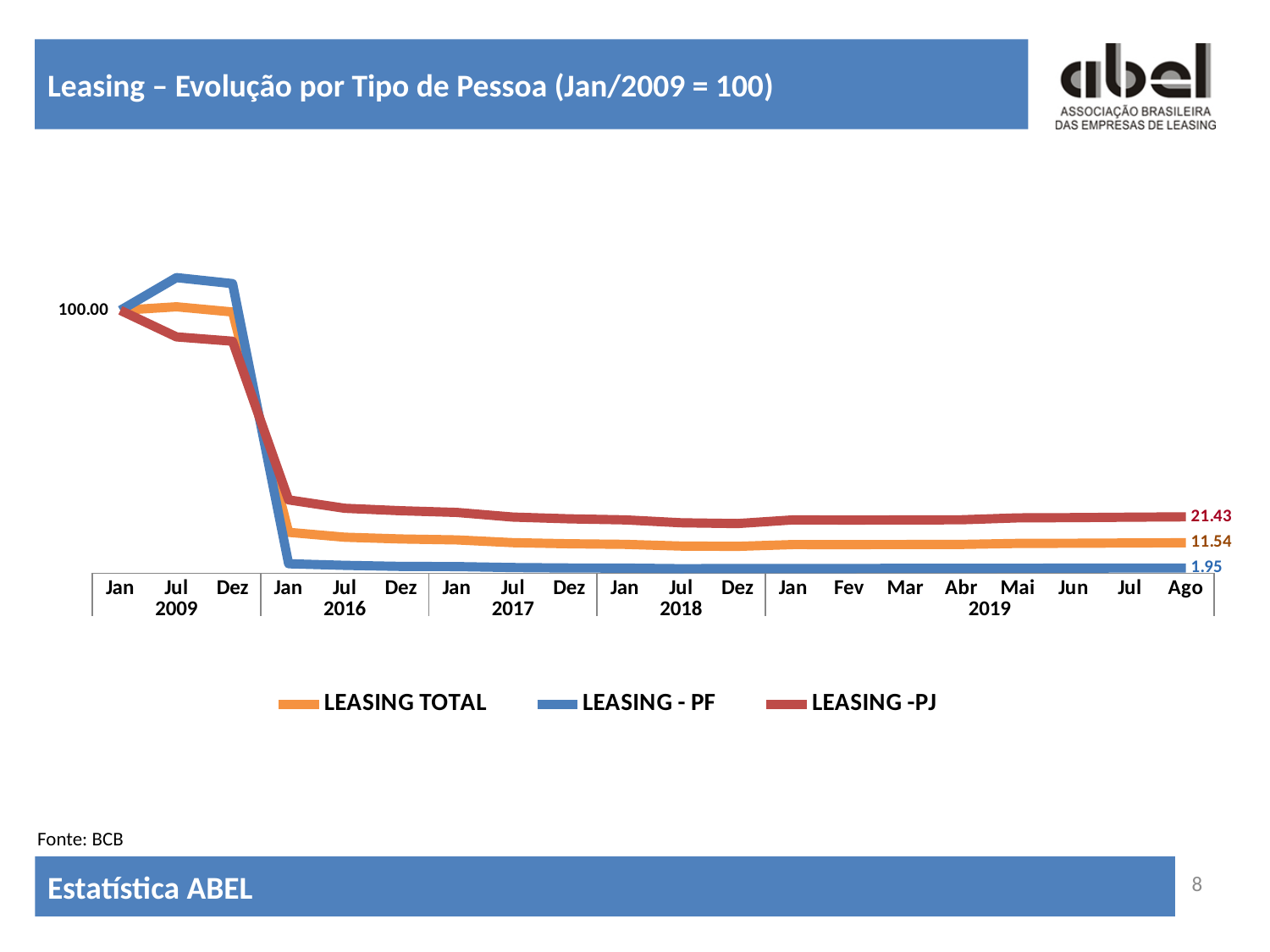
What is the difference between LEASING -PJ and LEASING - PF in Ago 2019? 19.48 Do the values of LEASING TOTAL rise or fall from Jan 2009 to Ago 2019? Fall How many series does the legend list? 3 What kind of chart is shown on the slide? Line chart What is the value of the series in Jan 2009, the base period? 100.00 Which is larger in Ago 2019, LEASING TOTAL or LEASING - PF? LEASING TOTAL Which series has the highest value in Ago 2019? LEASING -PJ Which series has the lowest value in Ago 2019? LEASING - PF What is the value of LEASING TOTAL in Ago 2019? 11.54 What is the value of LEASING - PF in Ago 2019? 1.95 What is the value of LEASING -PJ in Ago 2019? 21.43 What is the difference between LEASING -PJ and LEASING TOTAL in Ago 2019? 9.89